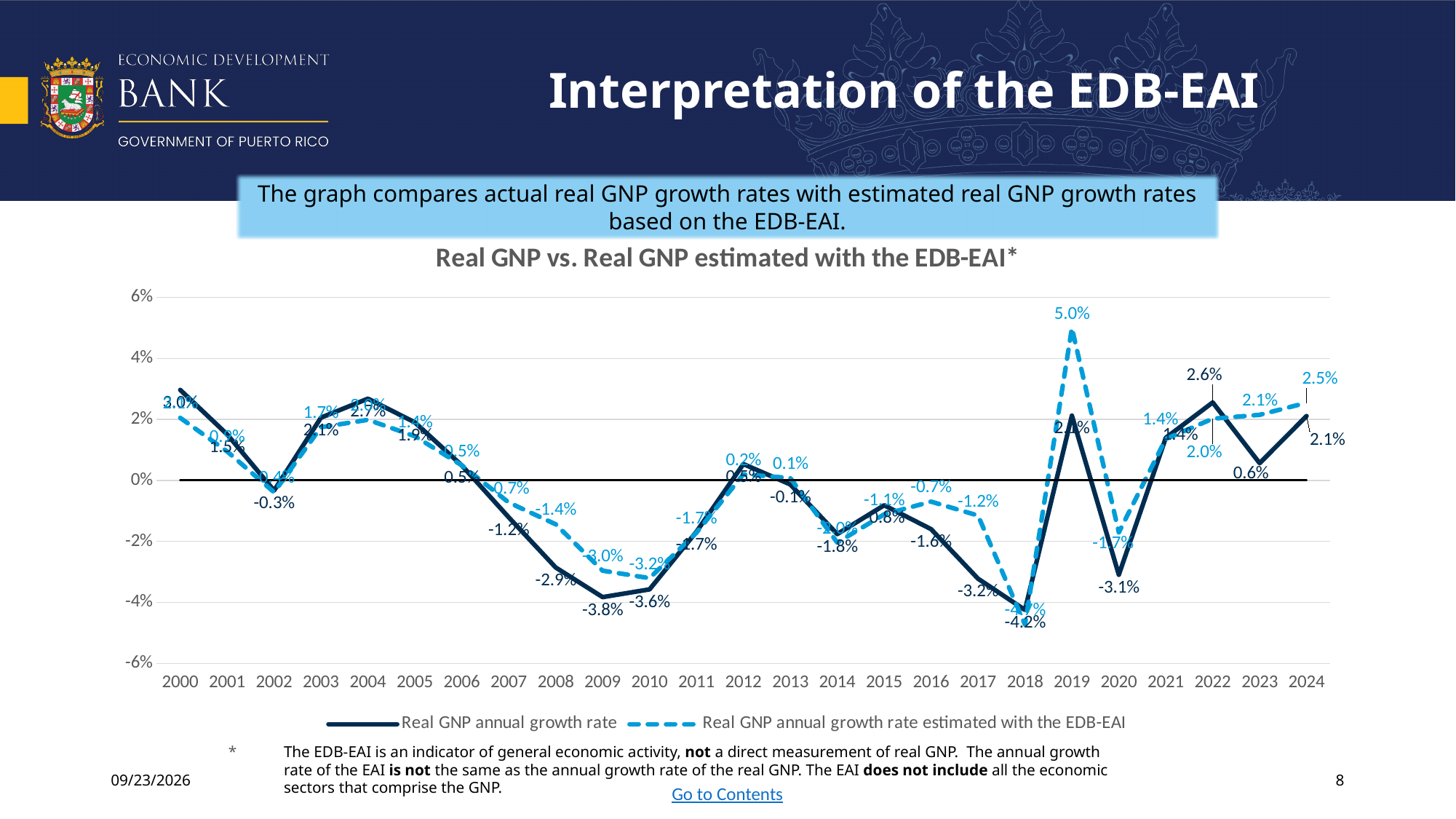
What is the Real GNP annual growth rate for 2020? -3.1% What is the Real GNP annual growth rate for 2022? 2.6% In 2023, which series has the higher value: the Real GNP annual growth rate or the rate estimated with the EDB-EAI? Real GNP annual growth rate estimated with the EDB-EAI How many series does the legend list? 2 In which year is the Real GNP annual growth rate estimated with the EDB-EAI highest? 2019 What is the Real GNP annual growth rate estimated with the EDB-EAI for 2024? 2.5% How many years are plotted along the x axis? 25 What is the Real GNP annual growth rate for 2018? -4.2% In which year is the Real GNP annual growth rate lowest? 2018 What is the Real GNP annual growth rate estimated with the EDB-EAI for 2019? 5.0% What type of chart is shown on the slide? Line chart